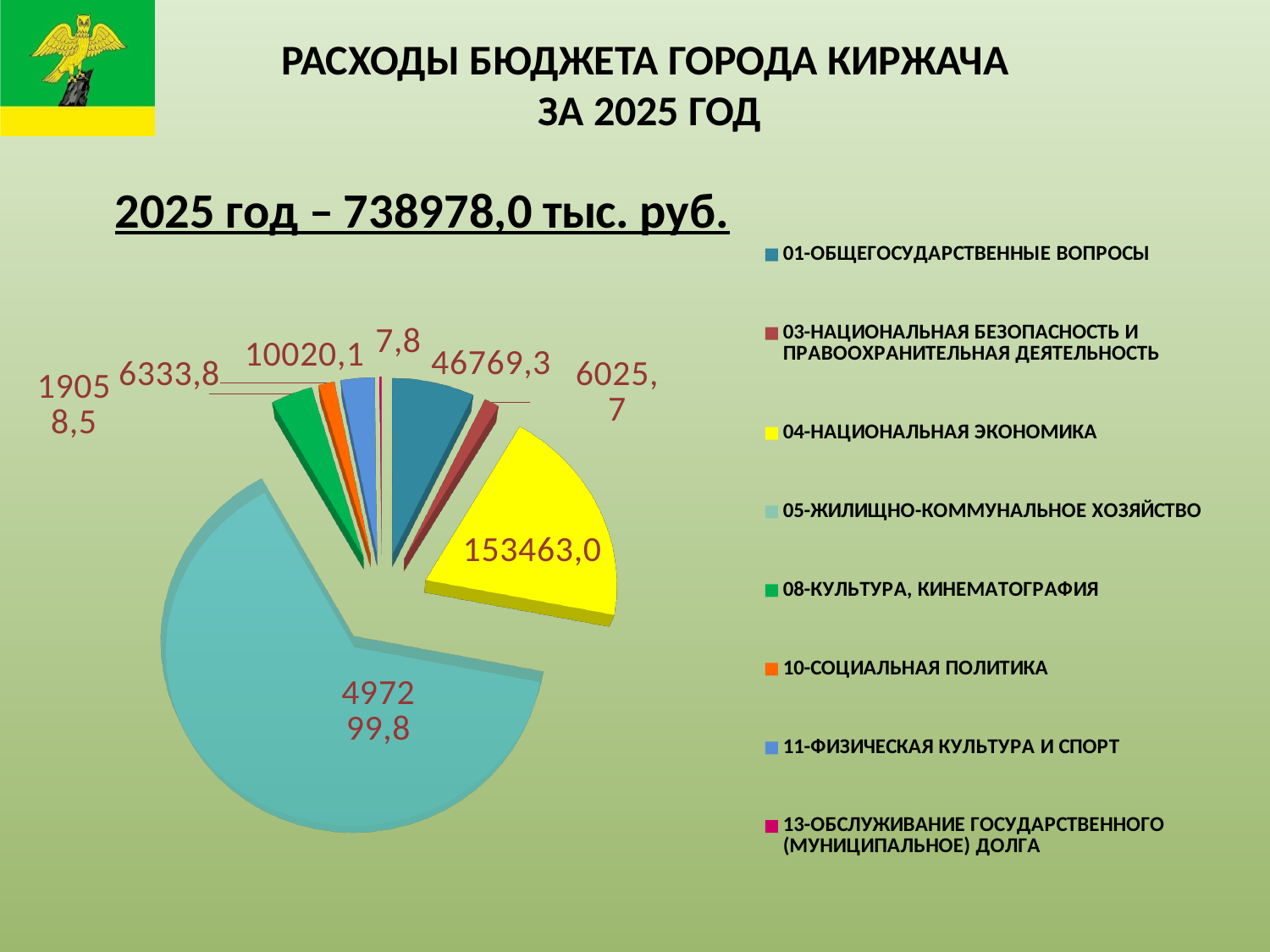
How many categories does the legend list? 8 Which category has the smallest slice of the pie? 13-ОБСЛУЖИВАНИЕ ГОСУДАРСТВЕННОГО (МУНИЦИПАЛЬНОЕ) ДОЛГА What is the value for 13-ОБСЛУЖИВАНИЕ ГОСУДАРСТВЕННОГО (МУНИЦИПАЛЬНОЕ) ДОЛГА? 7,8 What is the value for 11-ФИЗИЧЕСКАЯ КУЛЬТУРА И СПОРТ? 10020,1 What is the value for 05-ЖИЛИЩНО-КОММУНАЛЬНОЕ ХОЗЯЙСТВО? 497299,8 Which is larger: the value for 08-КУЛЬТУРА, КИНЕМАТОГРАФИЯ or the value for 10-СОЦИАЛЬНАЯ ПОЛИТИКА? 08-КУЛЬТУРА, КИНЕМАТОГРАФИЯ What is the value for 01-ОБЩЕГОСУДАРСТВЕННЫЕ ВОПРОСЫ? 46769,3 What total amount for 2025 is stated above the chart? 738978,0 тыс. руб. What is the value for 04-НАЦИОНАЛЬНАЯ ЭКОНОМИКА? 153463,0 Which category has the largest slice of the pie? 05-ЖИЛИЩНО-КОММУНАЛЬНОЕ ХОЗЯЙСТВО What type of chart is shown on the slide? pie chart What is the difference between the values for 04-НАЦИОНАЛЬНАЯ ЭКОНОМИКА and 01-ОБЩЕГОСУДАРСТВЕННЫЕ ВОПРОСЫ? 106693,7